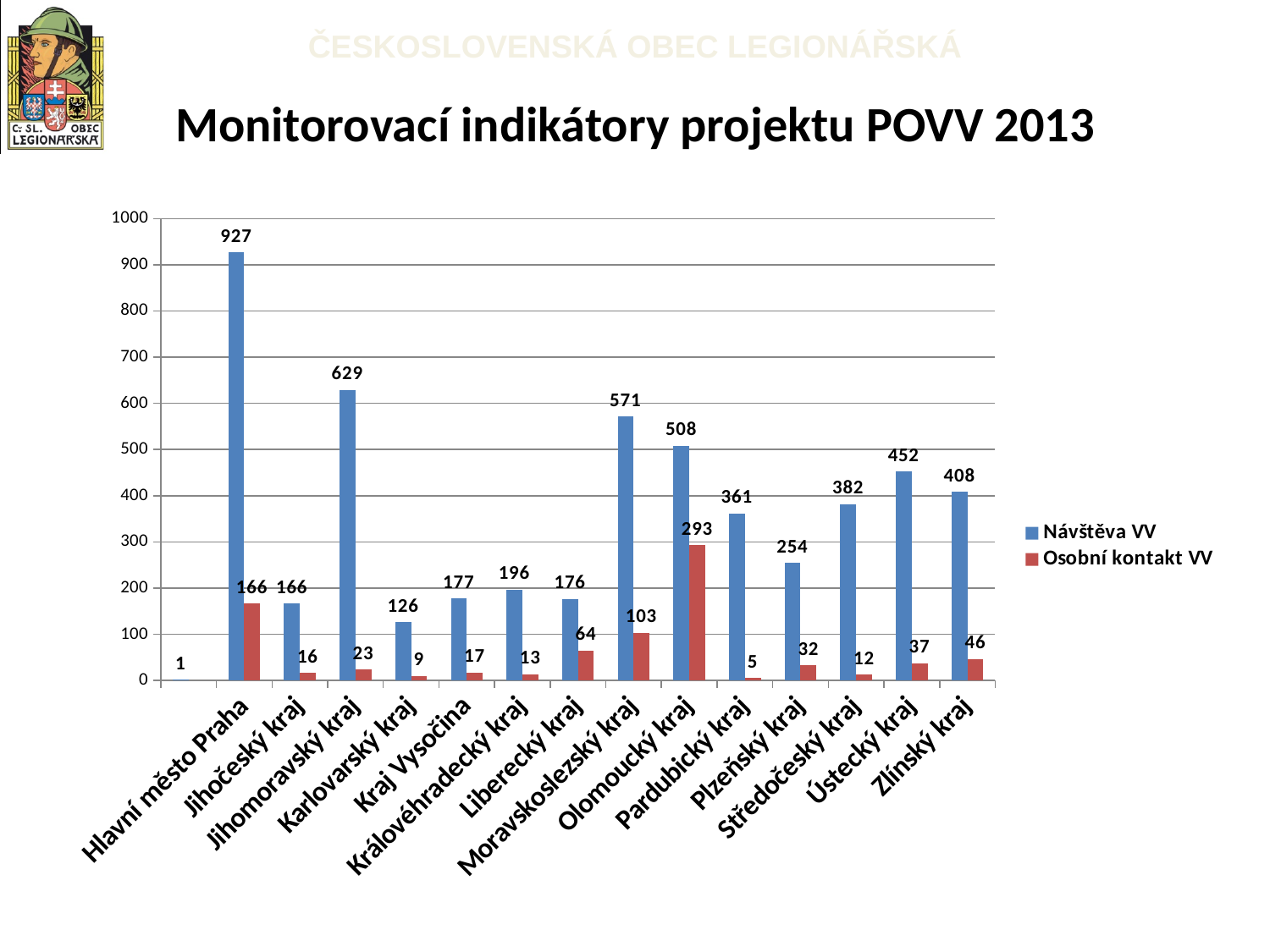
What is the difference between the Návštěva VV values for Jihomoravský kraj and Zlínský kraj? 221 How many categories are shown on the x axis? 14 Which is larger: the Návštěva VV value for Ústecký kraj or for Středočeský kraj? Ústecký kraj Which category has the highest Návštěva VV value? Hlavní město Praha What kind of chart is shown on the slide? bar chart How many series does the legend list? 2 What is the title of the slide? Monitorovací indikátory projektu POVV 2013 Is the Návštěva VV value for Plzeňský kraj greater or less than 300? less Which category has the lowest Osobní kontakt VV value? Pardubický kraj What is the Návštěva VV value for Hlavní město Praha? 927 What is the Návštěva VV value for Moravskoslezský kraj? 571 What is the Osobní kontakt VV value for Olomoucký kraj? 293